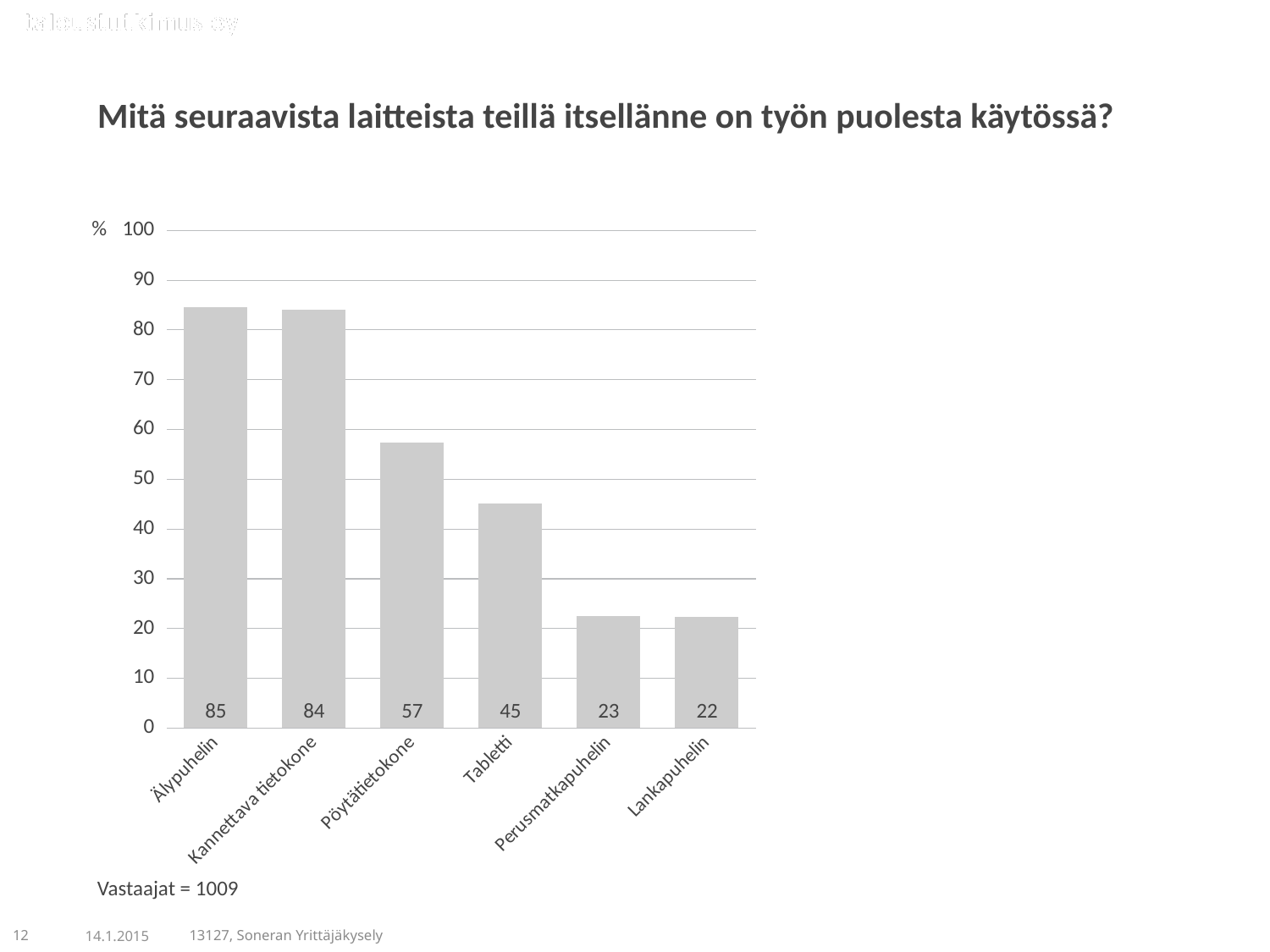
What is the value for Tabletti? 45 What is the value for Kannettava tietokone? 84 What kind of chart is shown on the slide? bar chart Which category has the lowest value? Lankapuhelin What is the difference between the values for Älypuhelin and Tabletti? 40 Which category has the highest value? Älypuhelin How many categories are shown in the chart? 6 What is the value for Lankapuhelin? 22 What is the value for Pöytätietokone? 57 What is the difference between the values for Pöytätietokone and Perusmatkapuhelin? 34 What is the title of the chart? Mitä seuraavista laitteista teillä itsellänne on työn puolesta käytössä? Which is larger, the value for Pöytätietokone or the value for Tabletti? Pöytätietokone